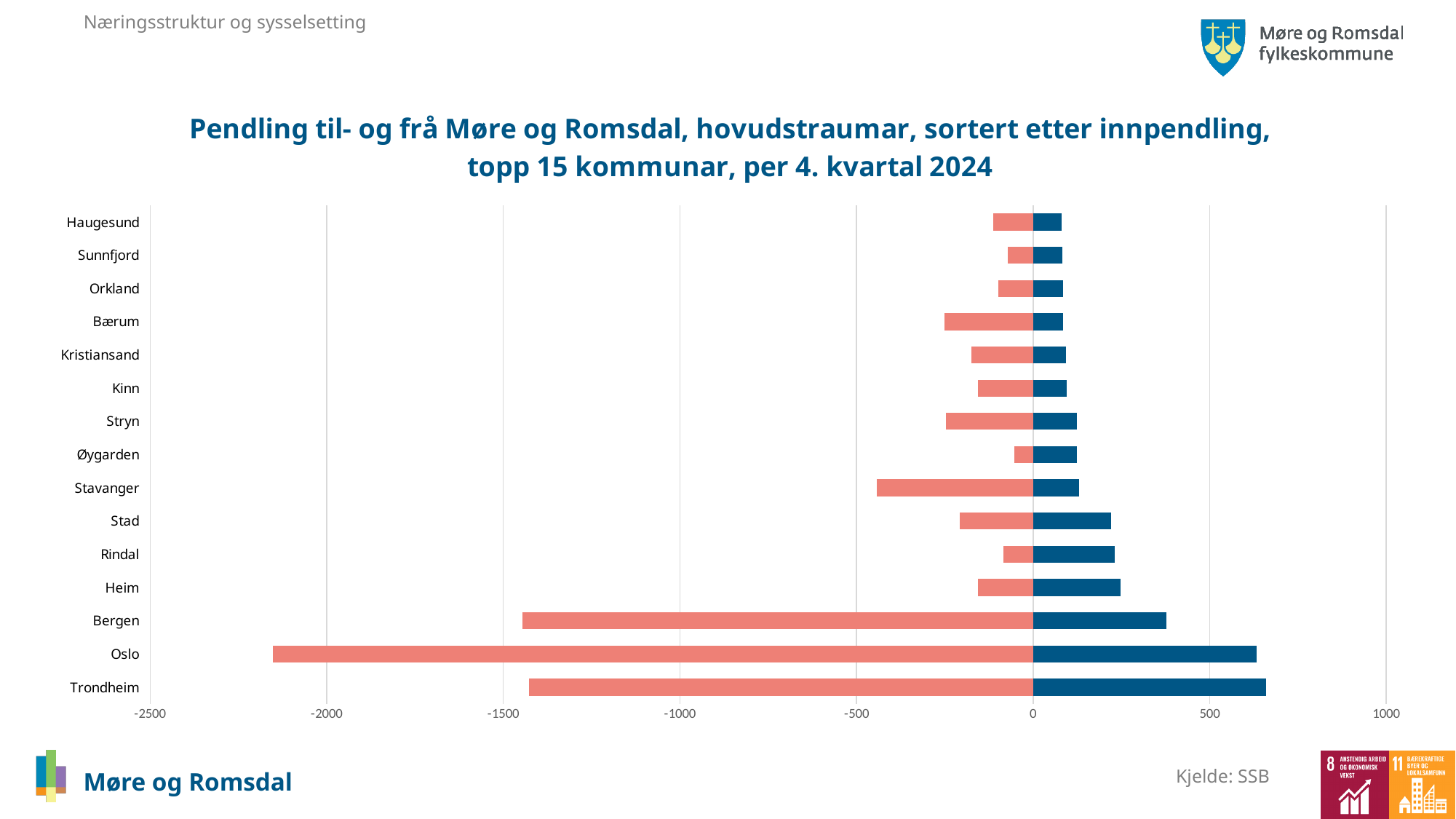
Which municipality has the longest red (negative) bar in the chart? Oslo How many municipalities (categories) are listed on the vertical axis of the chart? 15 What kind of chart is shown on the slide? Bar chart Is the red (negative) value for Bergen greater or less than -1500? greater Is the blue (positive) value for Bergen greater or less than 500? less Which has the longer blue (positive) bar, Bergen or Heim? Bergen What is the title of the chart? Pendling til- og frå Møre og Romsdal, hovudstraumar, sortert etter innpendling, topp 15 kommunar, per 4. kvartal 2024 Is the blue (positive) value for Trondheim greater or less than 500? greater Which has the longer red (negative) bar, Stavanger or Bærum? Stavanger What source (kjelde) is cited for the chart data? SSB Going from the top of the chart (Haugesund) to the bottom (Trondheim), do the blue bars generally get longer or shorter? longer